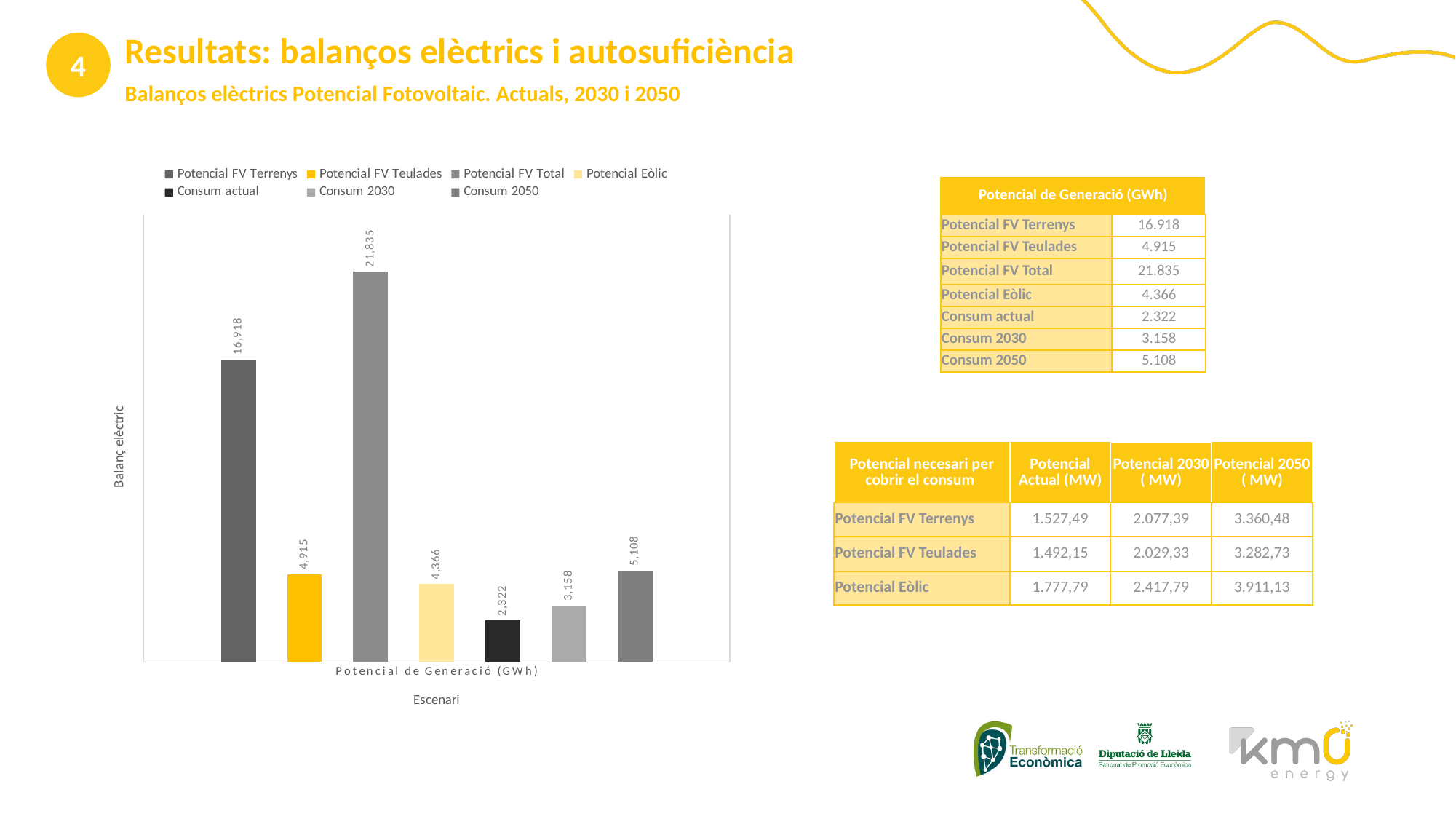
What value is shown for Potencial FV Terrenys in the chart? 16,918 Which is larger in the chart, Potencial FV Teulades or Potencial Eòlic? Potencial FV Teulades Which series has the lowest value in the chart? Consum actual What value is shown for Consum 2050 in the chart? 5,108 What kind of chart is shown on the slide? Bar chart What value is shown for Potencial FV Teulades in the chart? 4,915 What is the difference between Potencial FV Total and Potencial FV Terrenys in the chart? 4,917 What is the label on the vertical axis of the chart? Balanç elèctric Which series has the highest value in the chart? Potencial FV Total What value is shown for Potencial Eòlic in the chart? 4,366 How many series does the chart legend list? 7 What is the difference between Consum 2050 and Consum 2030 in the chart? 1,950